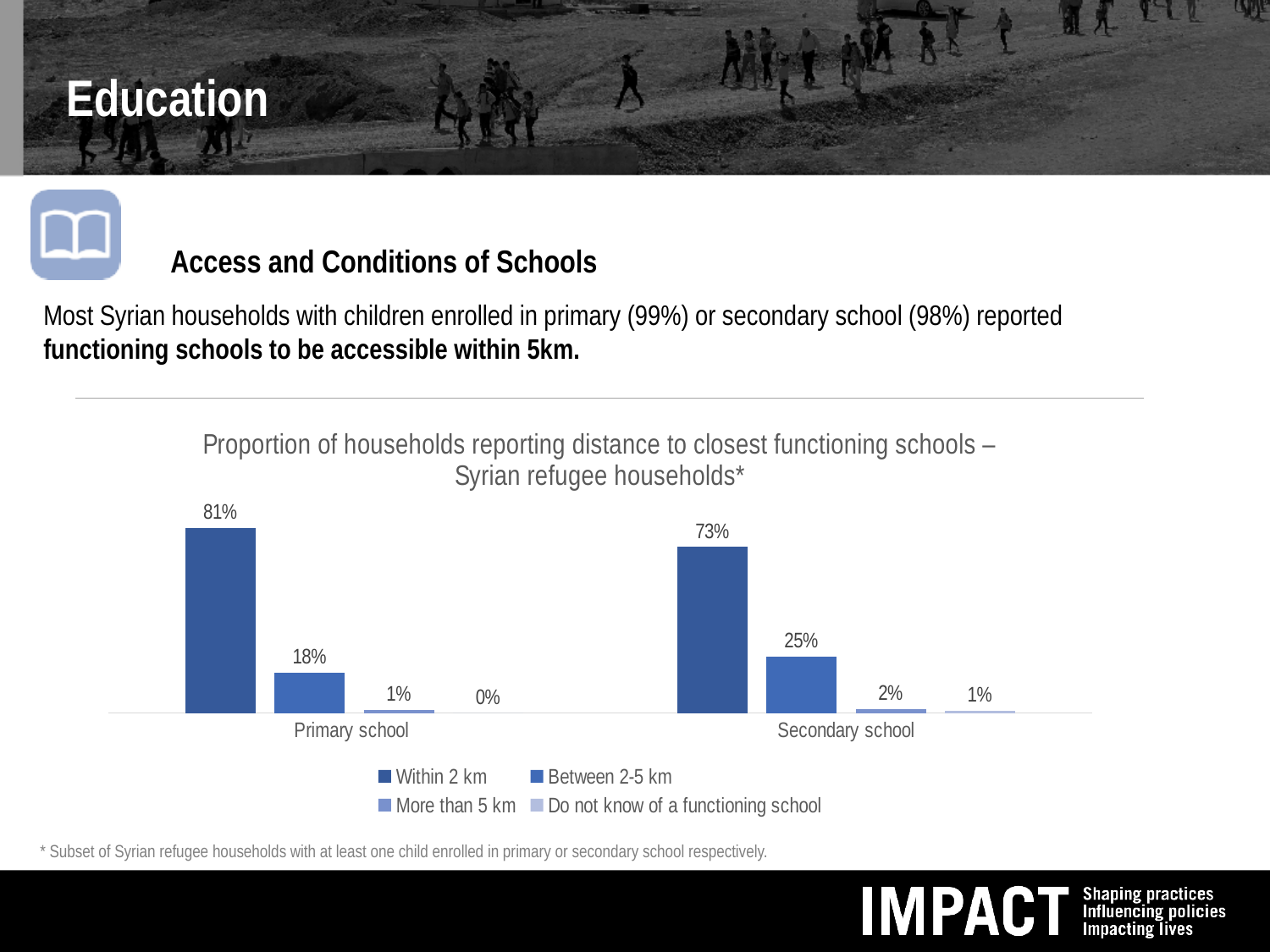
Which series has the highest value for secondary school? Within 2 km What percentage of households with children in primary school reported a functioning school within 2 km? 81% What is the title of the chart? Proportion of households reporting distance to closest functioning schools – Syrian refugee households* What is the difference between the 'Within 2 km' values for primary school and secondary school? 8% What percentage of households with children in secondary school reported a functioning school between 2-5 km away? 25% What is the value for 'More than 5 km' for secondary school? 2% Which series has the lowest value for primary school? Do not know of a functioning school What kind of chart is shown on the slide? Bar chart What is the value for 'Do not know of a functioning school' for primary school? 0% Which is larger: the 'Between 2-5 km' value for primary school or for secondary school? Secondary school How many series does the legend list? 4 How many categories are shown on the x axis? 2